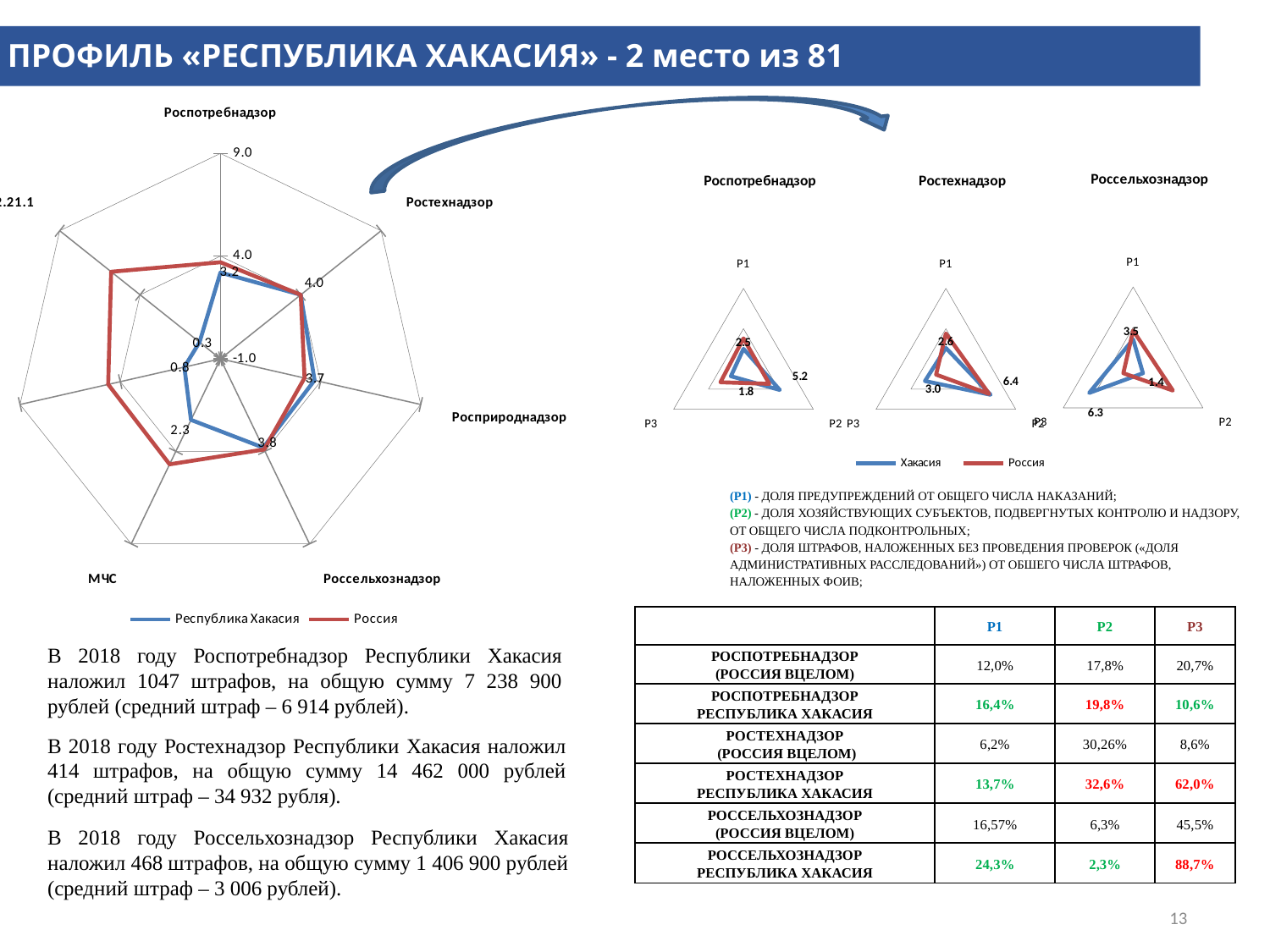
In the large chart on the left, which series has the larger value on the Роспотребнадзор axis, Республика Хакасия or Россия? Россия How many series does the shared legend of the small radar charts on the right list? 2 In the small Россельхознадзор radar chart, which series has the larger value on the P3 axis, Хакасия or Россия? Хакасия In the small Роспотребнадзор radar chart, which series has the larger value on the P2 axis, Хакасия or Россия? Хакасия How many series does the legend of the large chart on the left list? 2 What are the two series named in the legend of the large chart on the left? Республика Хакасия and Россия What kind of chart is the large chart on the left of the slide? radar chart In the large chart on the left, what is the value for Республика Хакасия on the Роспотребнадзор axis? 3.2 How many axes (categories) does each small radar chart on the right have? 3 How many small radar charts are shown on the right side of the slide? 3 What are the titles of the three small radar charts on the right? Роспотребнадзор, Ростехнадзор, Россельхознадзор